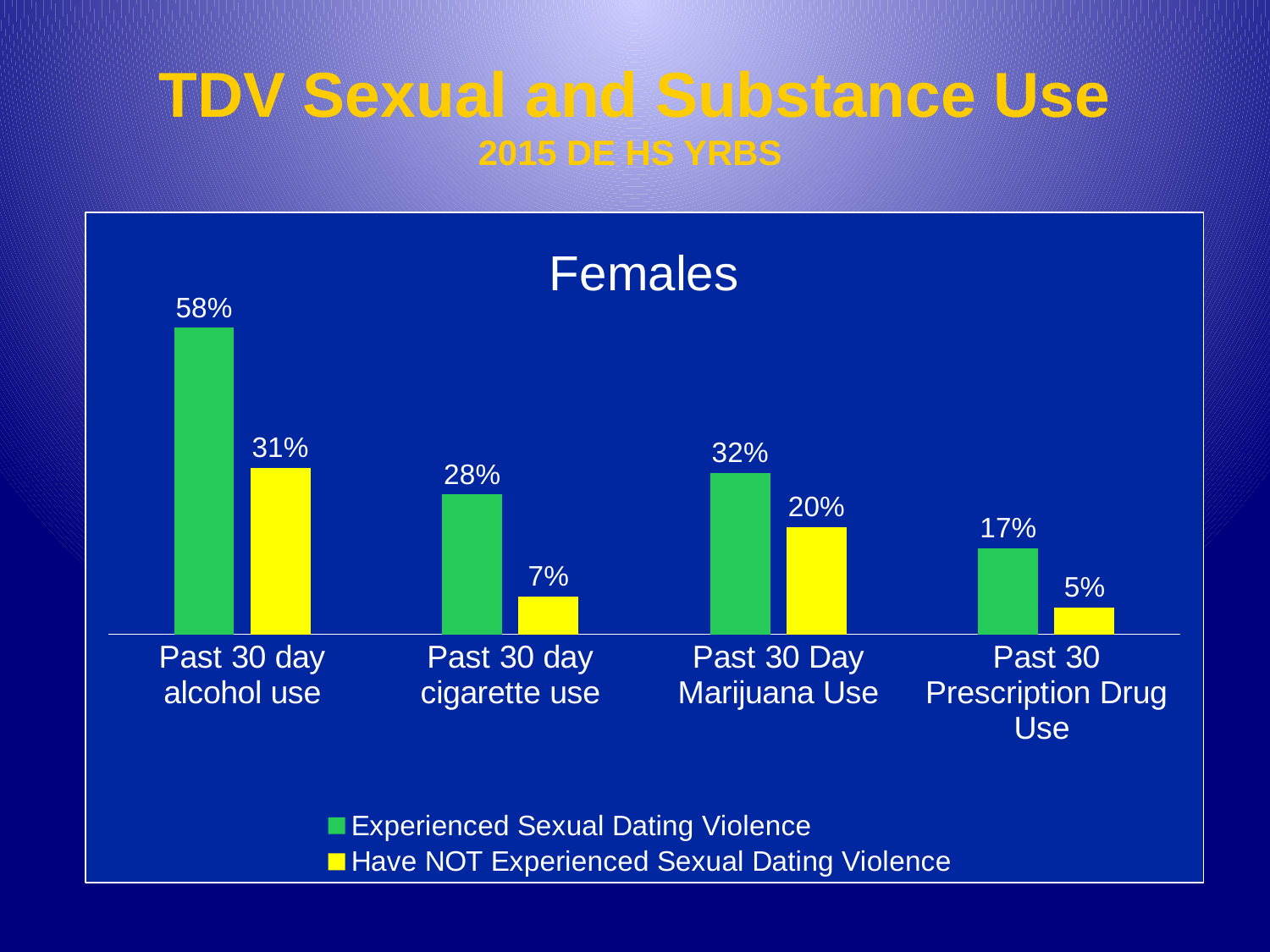
Which category has the lowest value for the Have NOT Experienced Sexual Dating Violence series? Past 30 Prescription Drug Use What is the value for Past 30 Prescription Drug Use among females who have NOT experienced sexual dating violence? 5% What is the difference between the two series for Past 30 day cigarette use? 21% What is the value for Past 30 day alcohol use among females who experienced sexual dating violence? 58% For Past 30 Day Marijuana Use, which series has the larger value? Experienced Sexual Dating Violence Which category has the highest value for the Experienced Sexual Dating Violence series? Past 30 day alcohol use How many series does the legend list? 2 What kind of chart is shown on the slide? Bar chart What is the difference between the two series for Past 30 day alcohol use? 27% How many categories are shown on the x axis? 4 What is the value for Past 30 day cigarette use among females who have NOT experienced sexual dating violence? 7% What is the value for Past 30 Day Marijuana Use among females who experienced sexual dating violence? 32%